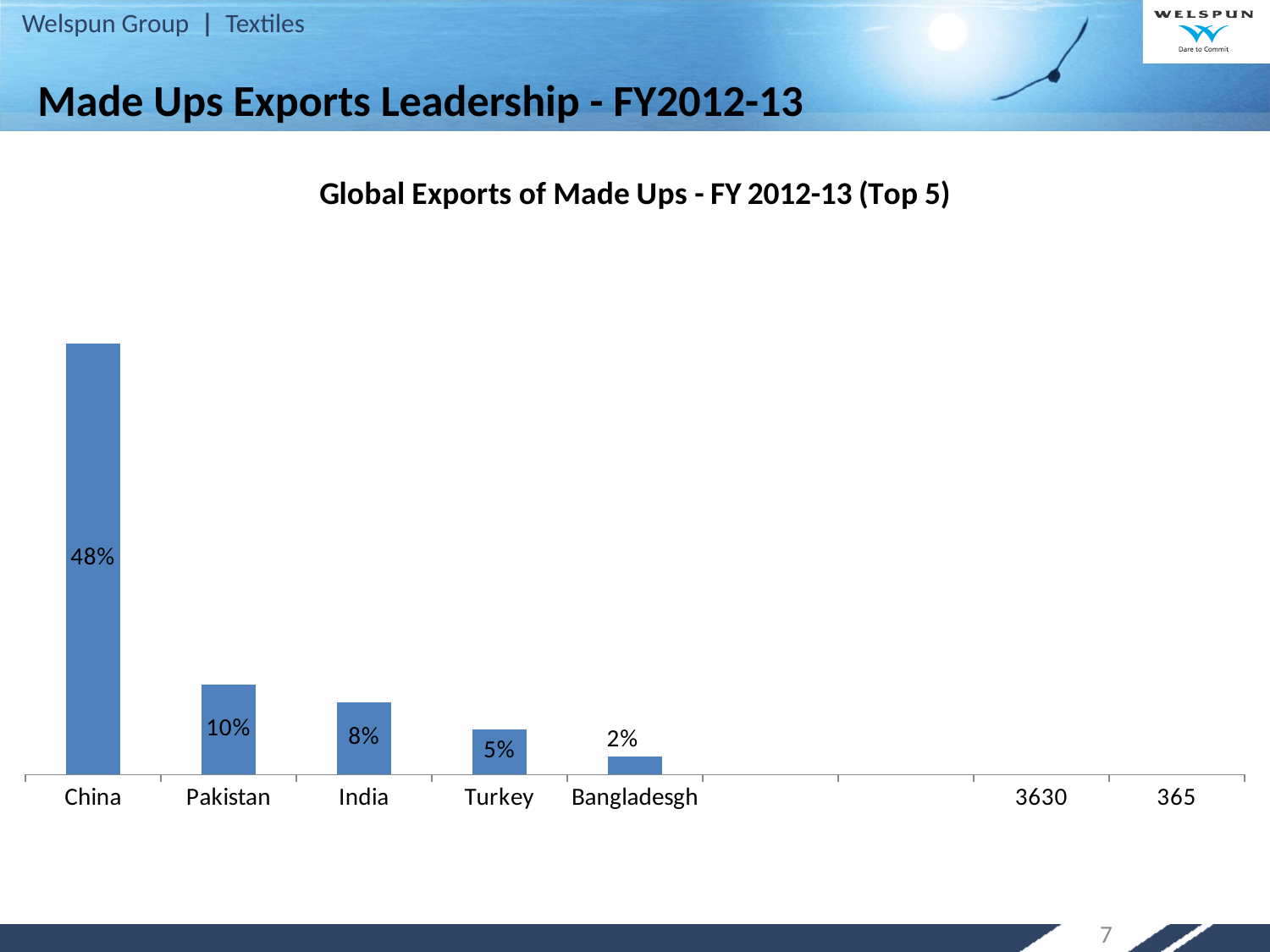
What is the difference between the values for India and Turkey? 3% Which country has the highest value? China How many bars are plotted in the chart? 5 What is the value for Turkey? 5% What is the value for Pakistan? 10% What kind of chart is shown on the slide? Bar chart Which is larger, the value for Pakistan or the value for India? Pakistan Which country has the lowest value among the bars shown? Bangladesgh What is the value for China? 48% What is the difference between the values for China and Pakistan? 38% What is the value for India? 8% What is the value for Bangladesgh? 2%